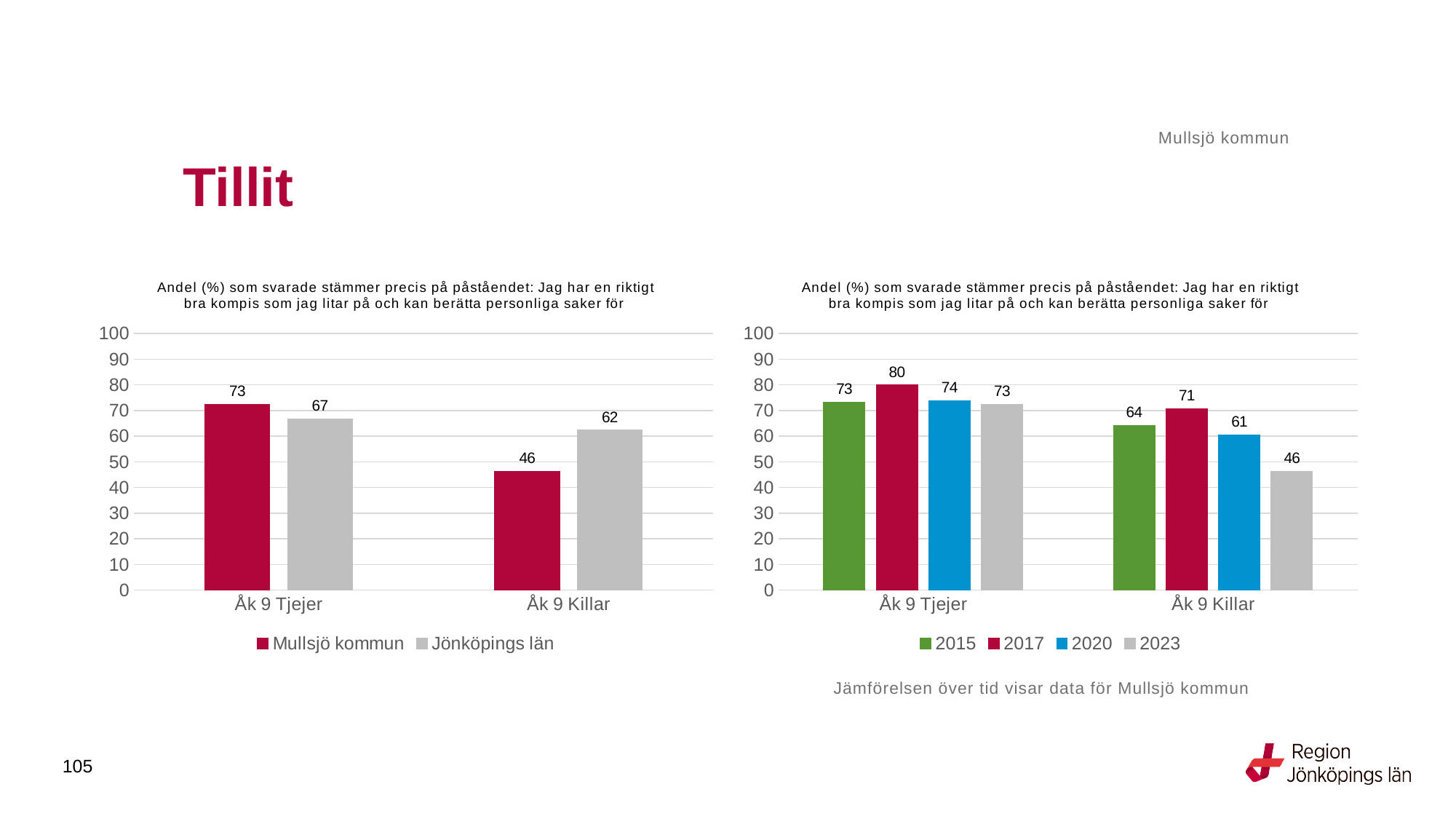
In the right chart, what is the difference between the 2017 and 2023 values for Åk 9 Killar? 25 In the left chart, what is the value for Jönköpings län for Åk 9 Killar? 62 In the right chart, which year has the highest value for Åk 9 Killar? 2017 In the right chart, how many series does the legend list? 4 What kind of chart is the right chart? Bar chart In the right chart, which year has the lowest value for Åk 9 Killar? 2023 In the left chart, which is larger for Åk 9 Tjejer: Mullsjö kommun or Jönköpings län? Mullsjö kommun In the right chart, what is the value for 2023 for Åk 9 Killar? 46 In the left chart, what is the value for Mullsjö kommun for Åk 9 Tjejer? 73 In the left chart, what is the difference between Mullsjö kommun and Jönköpings län for Åk 9 Killar? 16 In the right chart, what is the value for 2017 for Åk 9 Tjejer? 80 In the left chart, how many series does the legend list? 2